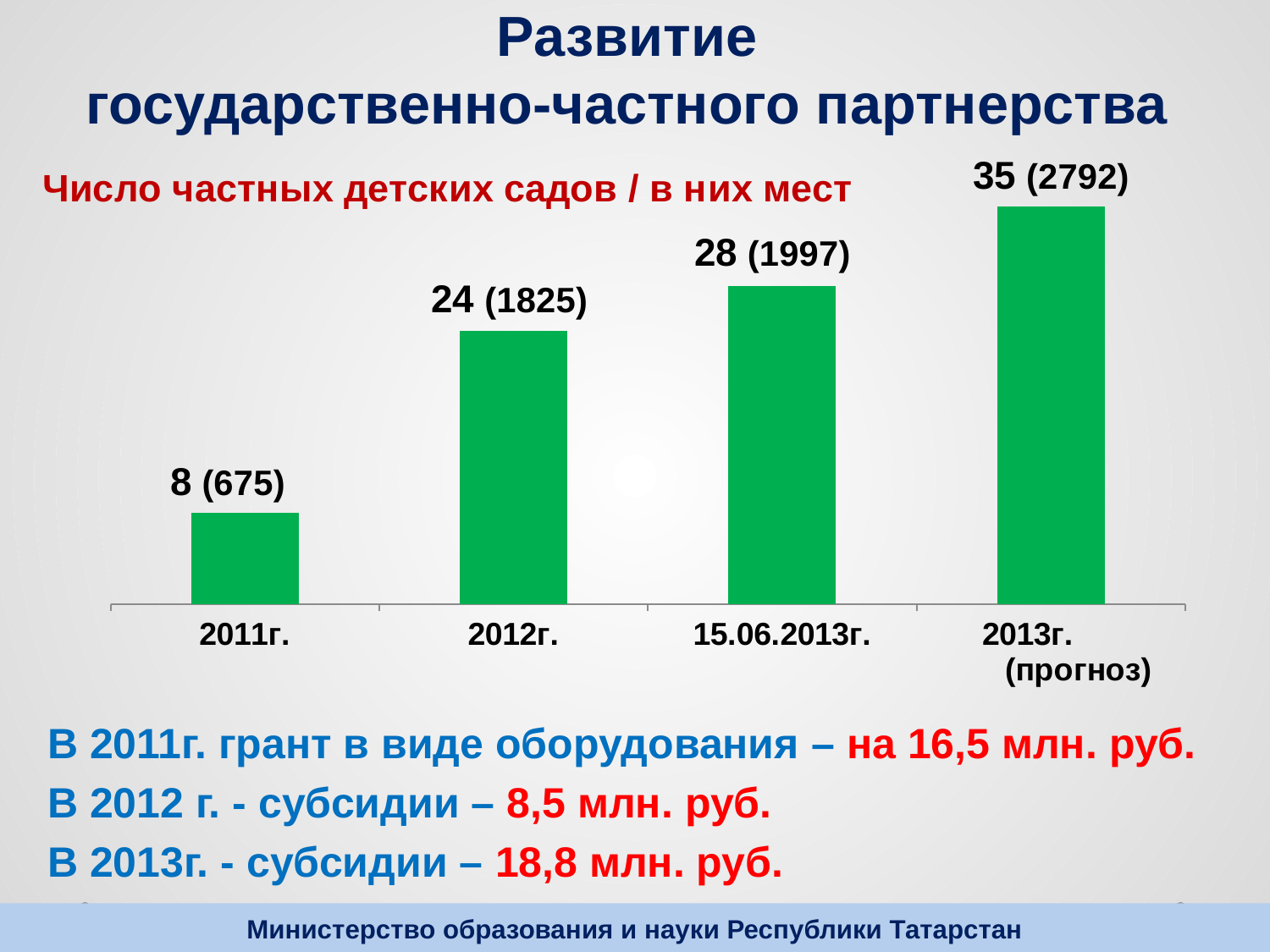
What is the data label on the bar for 2011г.? 8 (675) What is the data label on the bar for 2012г.? 24 (1825) What is the data label on the bar for 15.06.2013г.? 28 (1997) What is the difference in the number of places between 2013г. (прогноз) and 15.06.2013г.? 795 Do the values rise or fall from left to right along the x axis? rise Which category has the lowest bar? 2011г. How many bars (categories) does the chart show? 4 What is the data label on the bar for 2013г. (прогноз)? 35 (2792) What kind of chart is shown on the slide? bar chart Which category has the highest bar? 2013г. (прогноз) What is the title of the chart shown in red above the bars? Число частных детских садов / в них мест What is the difference in the number of private kindergartens between 2012г. and 2011г.? 16